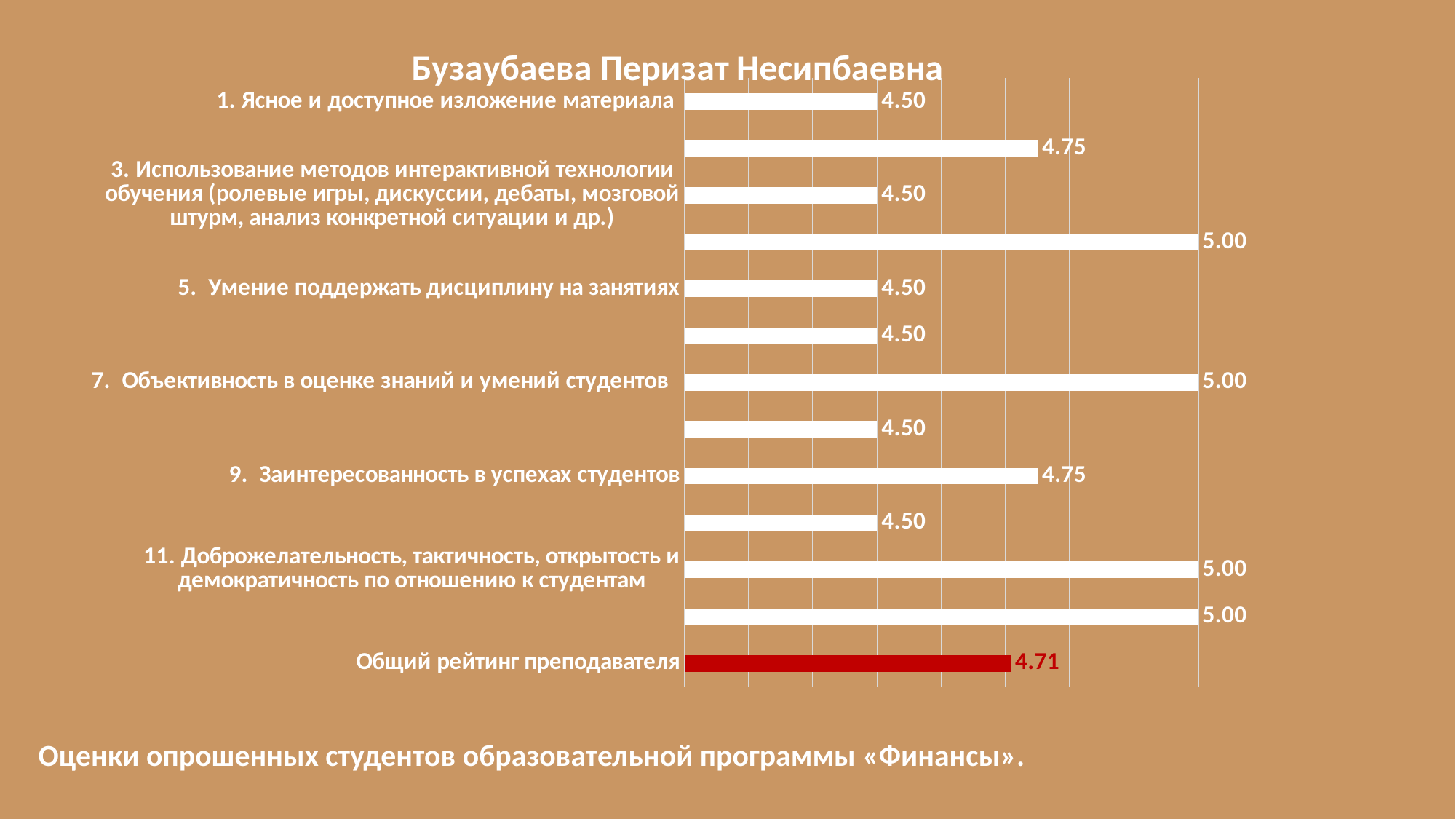
What is the title of the chart? Бузаубаева Перизат Несипбаевна What is the value for "1. Ясное и доступное изложение материала"? 4.50 What colour is the bar for "Общий рейтинг преподавателя"? Red What is the value for "Общий рейтинг преподавателя"? 4.71 What is the value for "7. Объективность в оценке знаний и умений студентов"? 5.00 Which is larger: the value for "7. Объективность в оценке знаний и умений студентов" or the value for "Общий рейтинг преподавателя"? 7. Объективность в оценке знаний и умений студентов What is the difference between the value for "9. Заинтересованность в успехах студентов" and the value for "1. Ясное и доступное изложение материала"? 0.25 How many bars are plotted in the chart? 13 What kind of chart is shown on the slide? Bar chart What is the value for "11. Доброжелательность, тактичность, открытость и демократичность по отношению к студентам"? 5.00 What is the value for "9. Заинтересованность в успехах студентов"? 4.75 What is the value for "5. Умение поддержать дисциплину на занятиях"? 4.50